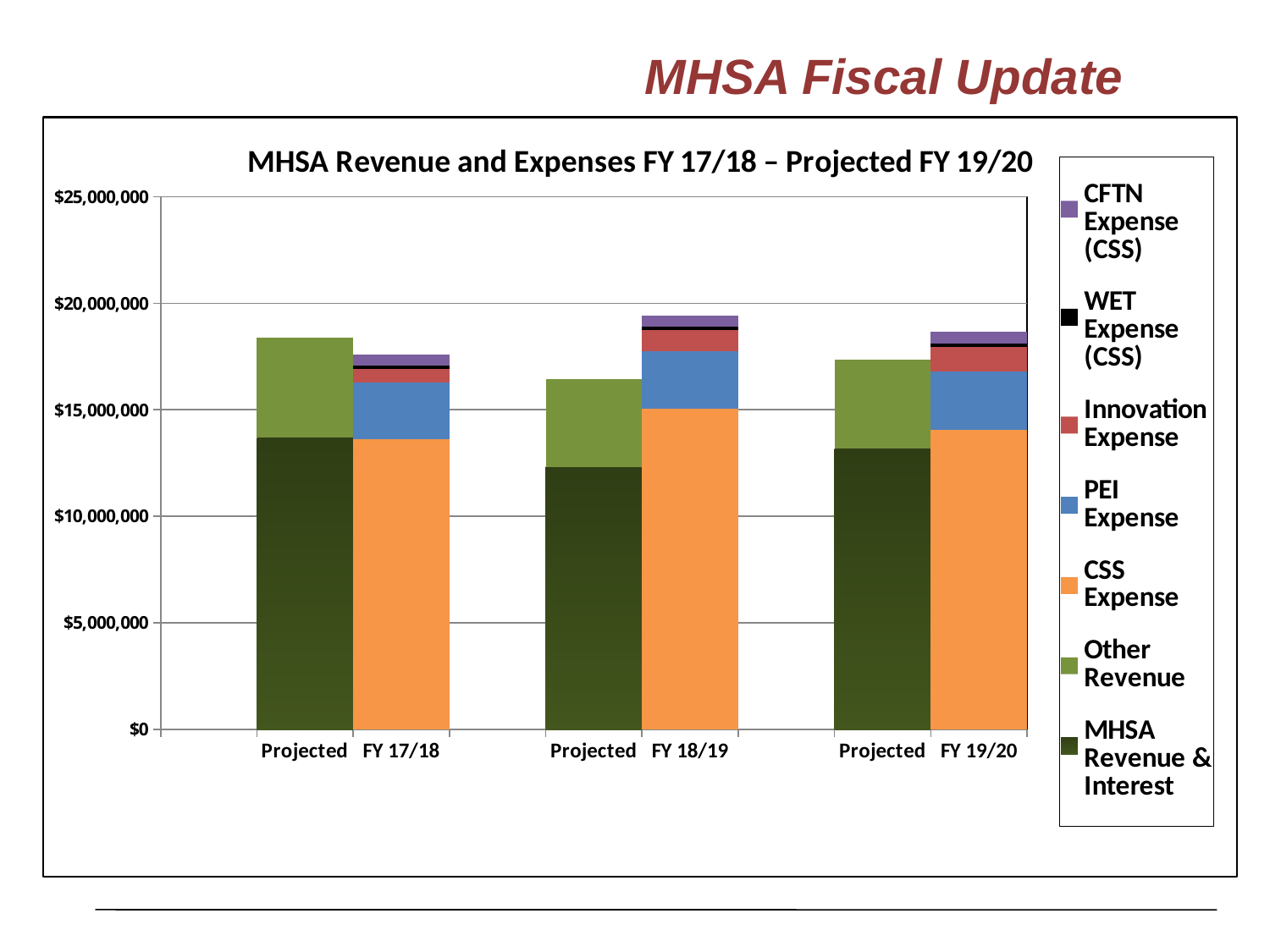
Which fiscal year has the tallest total expense bar? Projected FY 18/19 What kind of chart is shown on the slide? Stacked bar chart Is the total expense bar for Projected FY 18/19 greater or less than $20,000,000? less For Projected FY 18/19, which is larger, the total revenue bar or the total expense bar? Total expense bar What is the title of the chart? MHSA Revenue and Expenses FY 17/18 – Projected FY 19/20 Is the CSS Expense segment for Projected FY 17/18 greater or less than $15,000,000? less Which legend entry is shown in orange? CSS Expense Is the MHSA Revenue & Interest segment for Projected FY 18/19 greater or less than $10,000,000? greater Which fiscal year has the tallest total revenue bar? Projected FY 17/18 How many fiscal years are shown along the x axis? 3 How many series does the legend list? 7